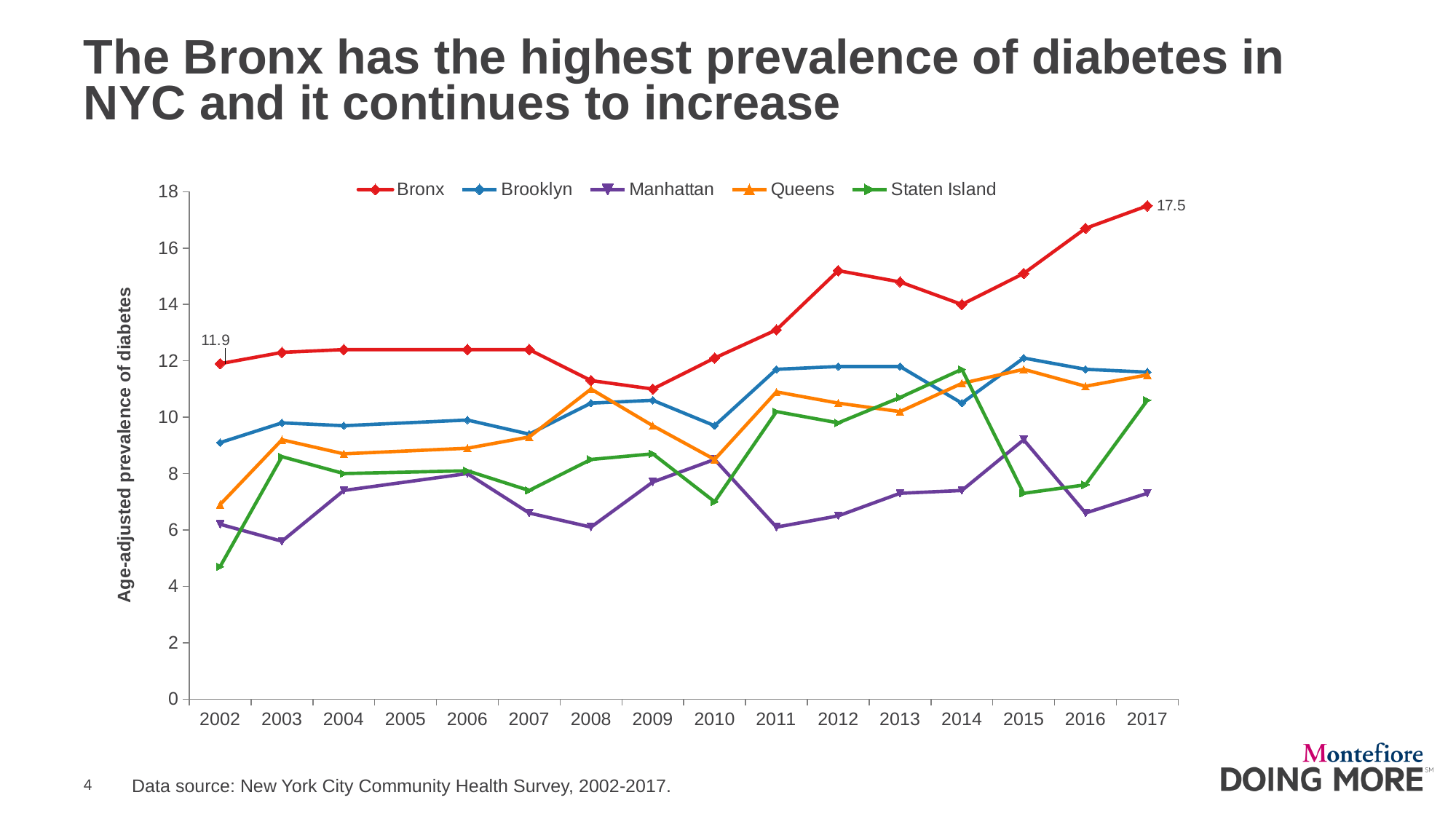
Which borough has the lowest prevalence of diabetes in 2002? Staten Island Does the Bronx line rise or fall from 2014 to 2017? Rises What is the age-adjusted prevalence of diabetes for the Bronx in 2002? 11.9 Is the value for the Bronx in 2012 greater or less than 14? greater What type of chart is shown on the slide? Line chart How many series does the legend list? 5 Which borough has the highest prevalence of diabetes in 2017? Bronx What is the age-adjusted prevalence of diabetes for the Bronx in 2017? 17.5 How many years are plotted along the x axis? 16 By how much did the Bronx value increase from 2002 to 2017? 5.6 Is the value for Staten Island in 2002 greater or less than 6? less Which borough has the lowest prevalence of diabetes in 2017? Manhattan